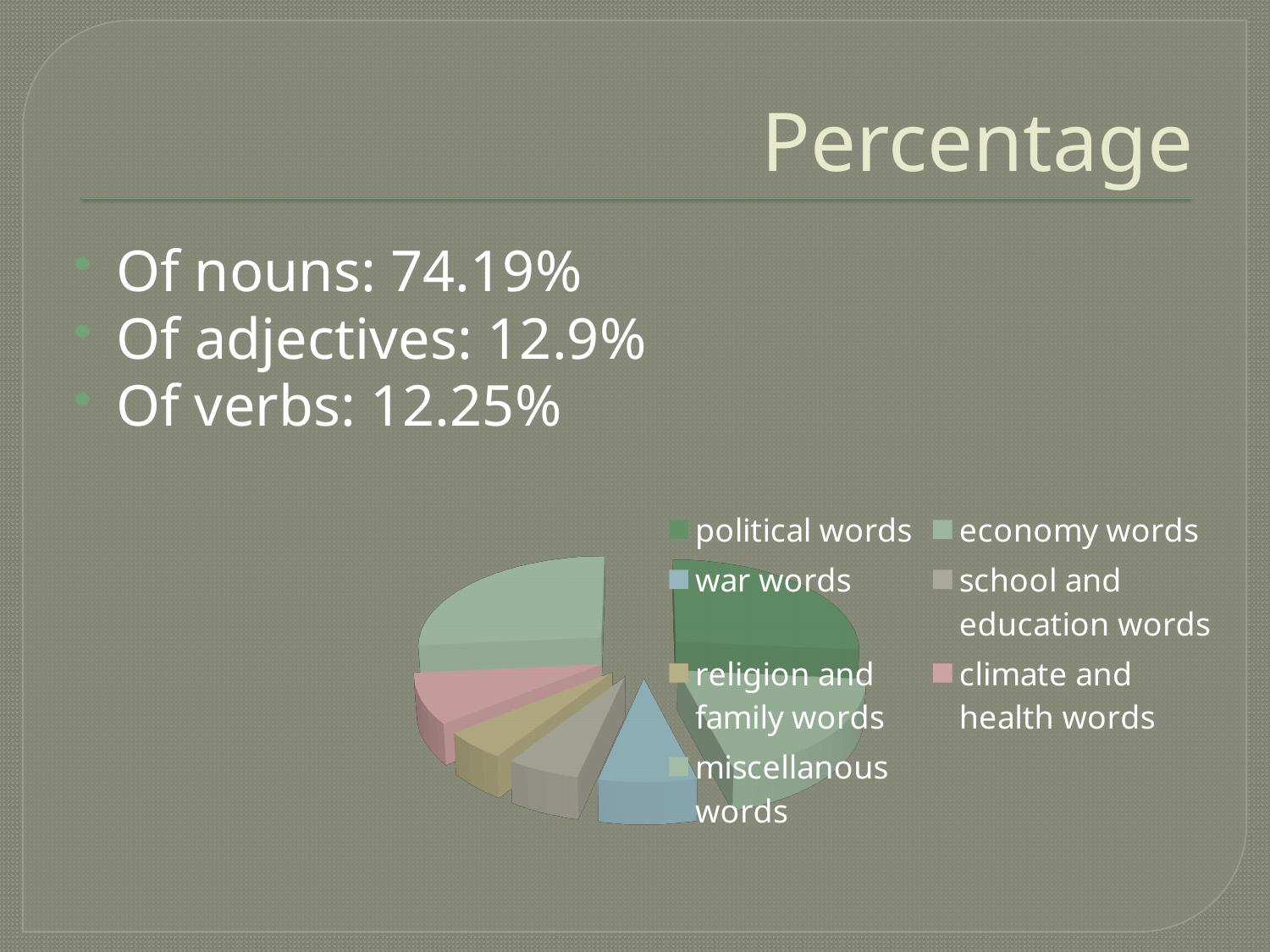
Which legend entry in the pie chart is shown in pink? climate and health words Which slice is larger in the pie chart, economy words or school and education words? economy words What kind of chart is shown on the slide? pie chart Which slice is larger in the pie chart, political words or climate and health words? political words Which slice is larger in the pie chart, political words or economy words? political words How many categories does the pie chart's legend list? 7 What colour is the political words slice in the pie chart? dark green